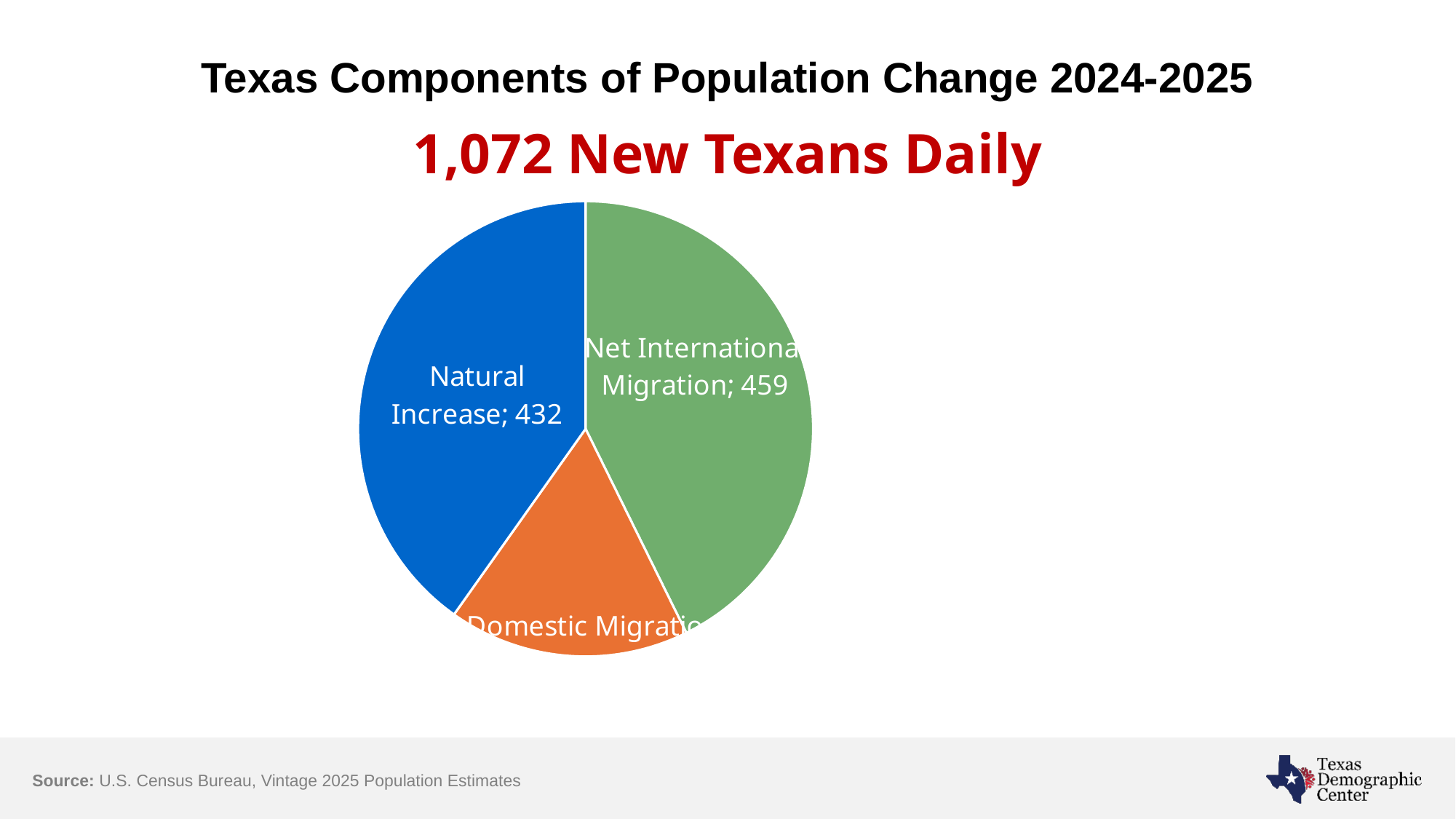
What is the title of the chart? Texas Components of Population Change 2024-2025 What is the value for Net International Migration? 459 What is the value for Natural Increase? 432 Which component has the largest slice of the pie? Net International Migration How many slices does the pie chart have? 3 What colour is the Natural Increase slice? blue Which component has the smallest slice of the pie? Domestic Migration What is the total number of new Texans daily shown on the slide? 1,072 What is the difference between Net International Migration and Natural Increase? 27 Which is larger, Natural Increase or Net International Migration? Net International Migration What kind of chart is shown on the slide? pie chart